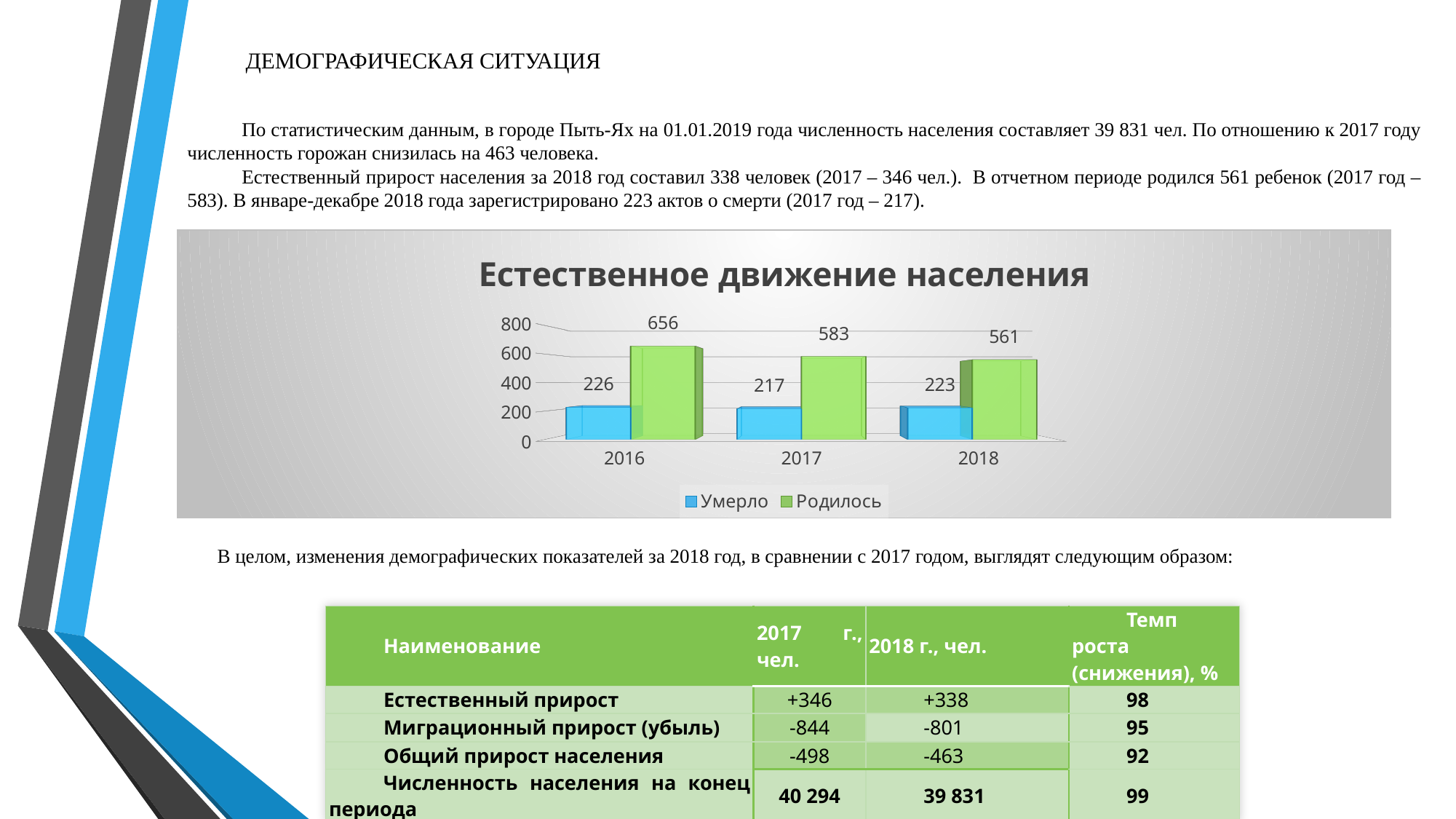
How many years are shown on the x axis? 3 What is the difference between Родилось and Умерло in 2018? 338 What kind of chart is shown? bar chart In which year is the Родилось value highest? 2016 In which year is the Умерло value lowest? 2017 What is the value for Родилось in 2016? 656 How many series does the legend list? 2 Is the value for Родилось in 2017 greater or less than 400? greater Which is larger: Умерло in 2016 or Умерло in 2018? Умерло in 2016 What is the value for Умерло in 2017? 217 Does the Родилось value rise or fall from 2016 to 2018? fall What is the value for Родилось in 2018? 561